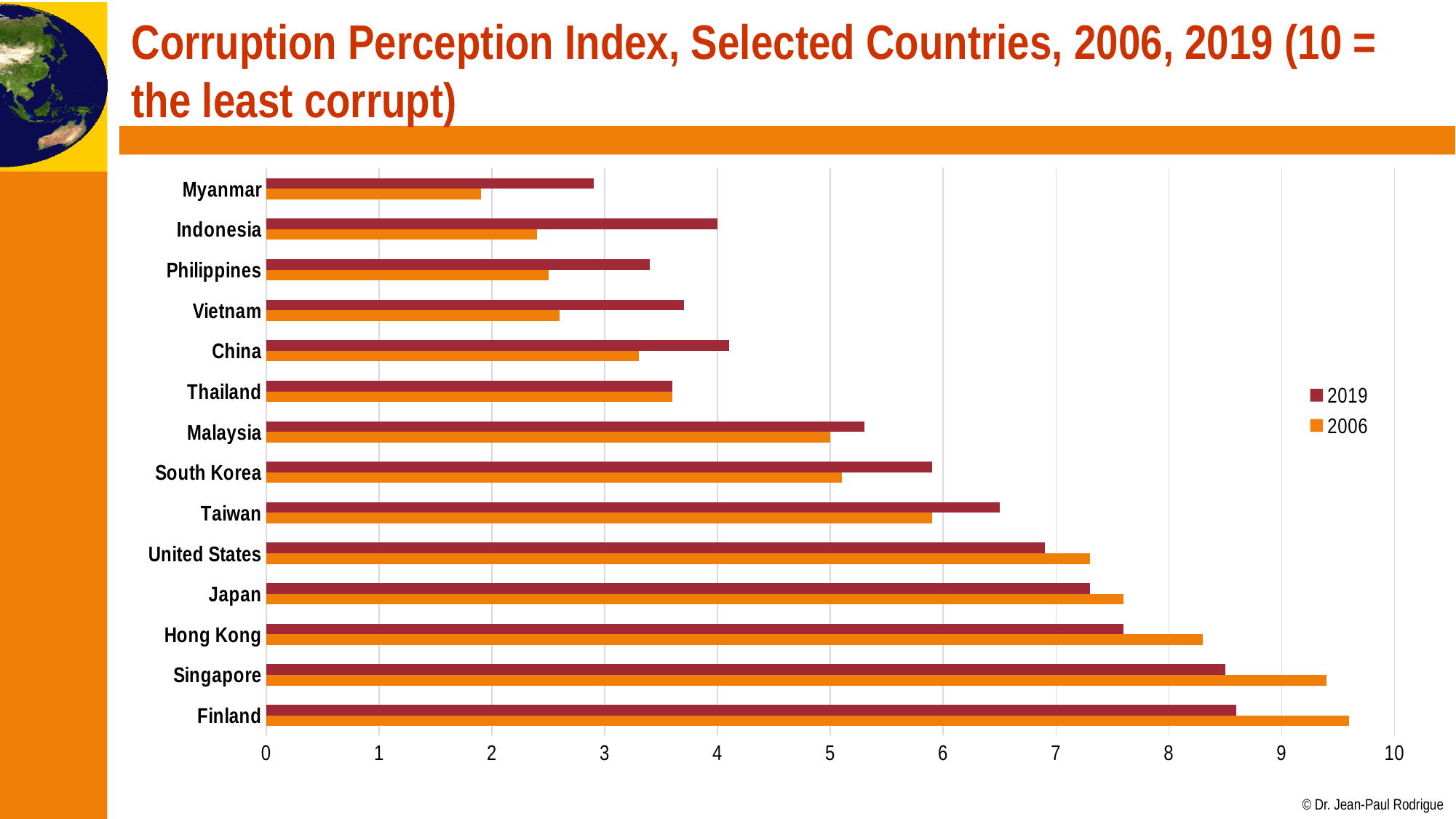
For Indonesia, which year has the larger value, 2019 or 2006? 2019 For Singapore, which year has the larger value, 2019 or 2006? 2006 Is the 2006 value for Singapore greater or less than 9? greater Which country has the lowest 2019 value? Myanmar Is the 2019 value for United States greater or less than 7? less Which country has the lowest 2006 value? Myanmar Is the 2006 value for Myanmar greater or less than 2? less How many countries are listed on the chart? 14 Which country has the highest 2006 value? Finland What kind of chart is shown on the slide? bar chart How many series does the legend list? 2